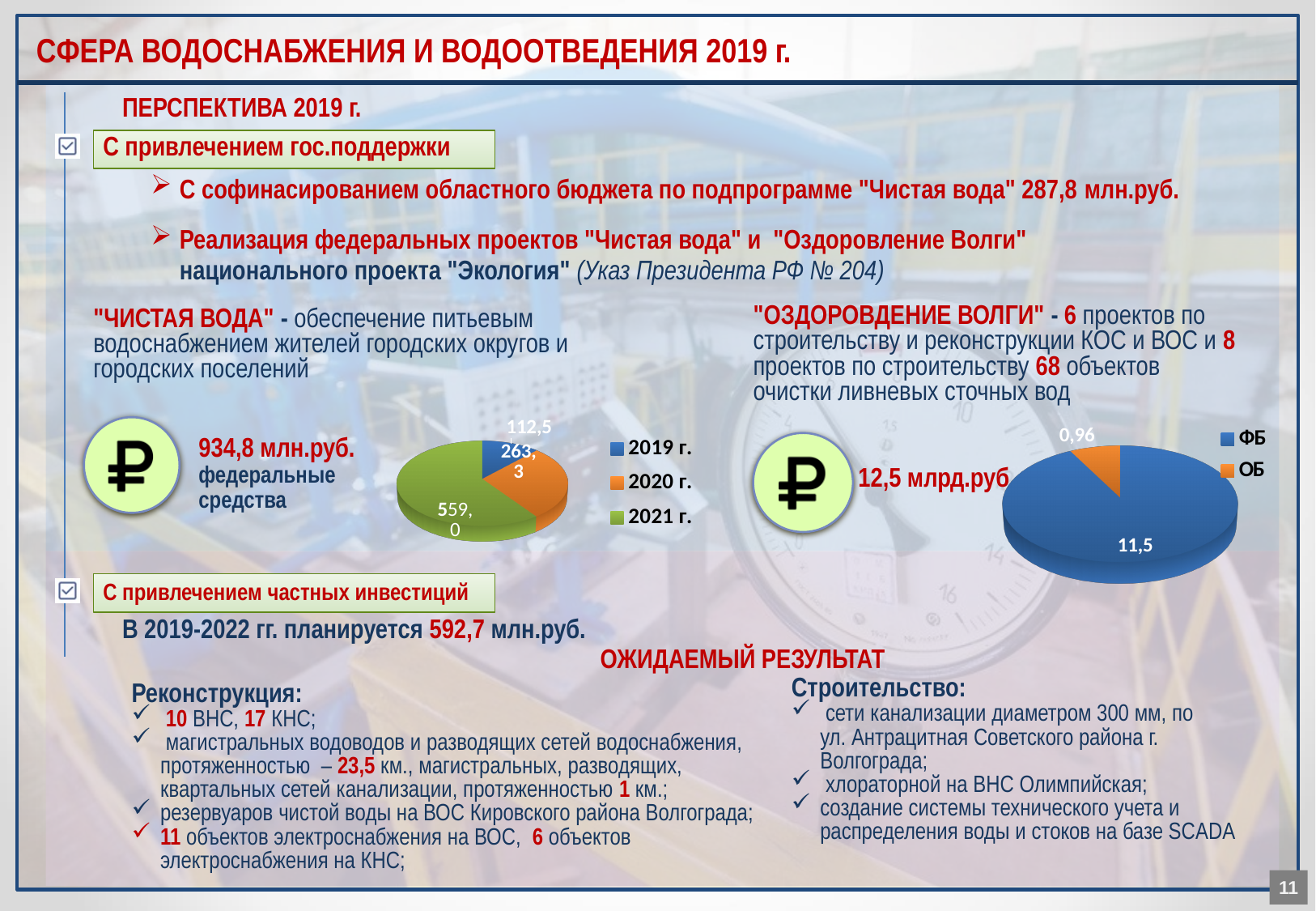
How many entries does the legend of the left pie chart (Чистая вода) list? 3 In the right pie chart (Оздоровление Волги), what is the value for ФБ? 11,5 In the right pie chart (Оздоровление Волги), what colour is the ОБ slice? orange What type of chart is used on the left side of the slide (next to "934,8 млн.руб.")? pie chart In the right pie chart (Оздоровление Волги), which is larger, ФБ or ОБ? ФБ In the right pie chart (Оздоровление Волги), what is the value for ОБ? 0,96 In the left pie chart (Чистая вода), what is the value for 2021 г.? 559,0 In the left pie chart (Чистая вода), what is the value for 2020 г.? 263,3 In the left pie chart (Чистая вода), what is the difference between the values for 2021 г. and 2020 г.? 295,7 In the left pie chart (Чистая вода), what is the value for 2019 г.? 112,5 In the left pie chart (Чистая вода), which year has the smallest slice? 2019 г. In the left pie chart (Чистая вода), which year has the largest slice? 2021 г.